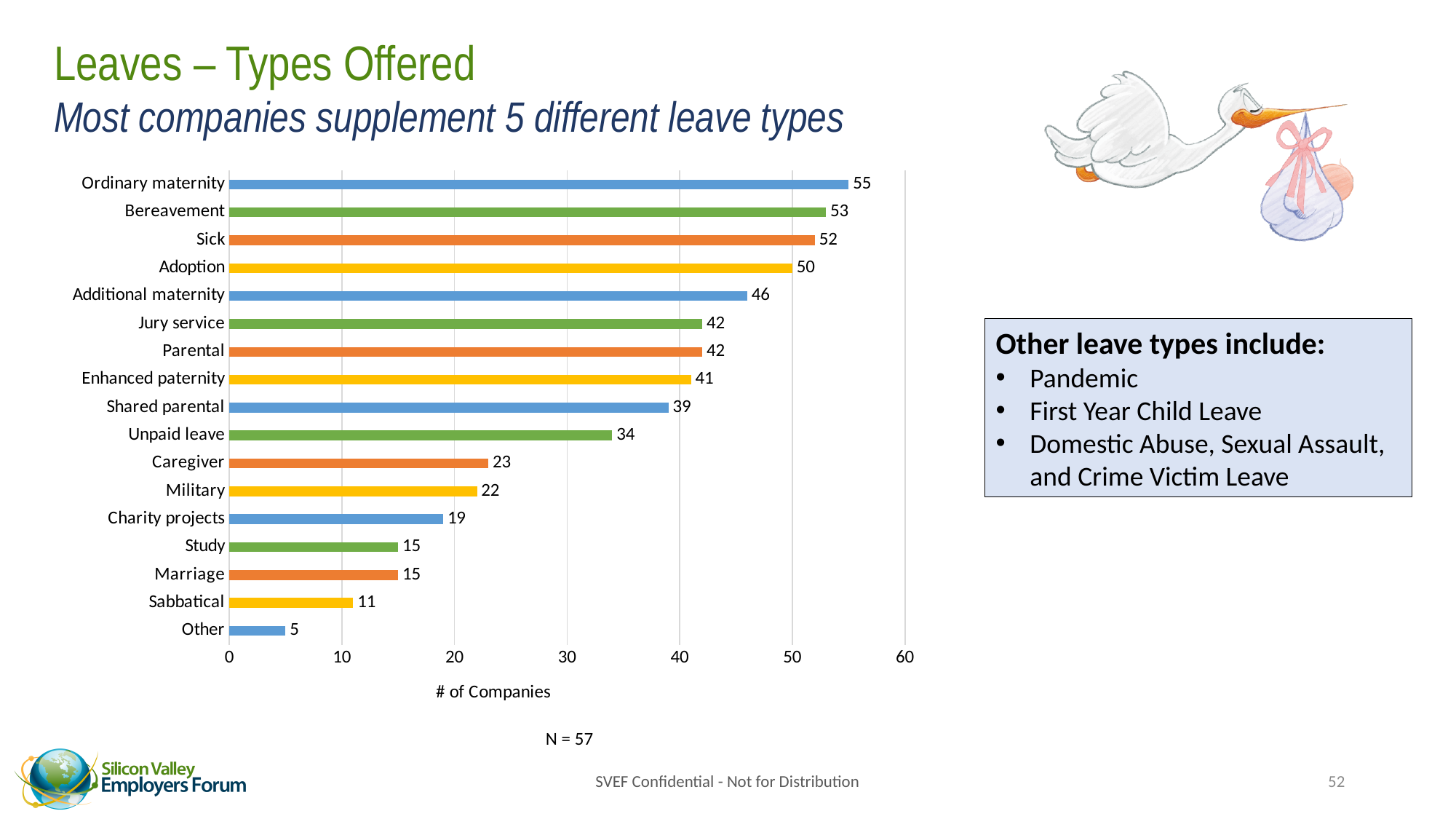
Which is larger, Shared parental or Additional maternity? Additional maternity Which has a higher value, Caregiver or Military? Caregiver How many companies offer Sabbatical leave? 11 What is the value for Unpaid leave? 34 What is the label of the horizontal axis of the chart? # of Companies What type of chart is shown on the slide? Bar chart What is the difference between Adoption and Charity projects? 31 How many leave type categories are shown in the chart? 17 What is the difference between the values for Bereavement and Sick? 1 Which category has the lowest value? Other Which leave type is offered by the most companies? Ordinary maternity How many companies offer Ordinary maternity leave? 55